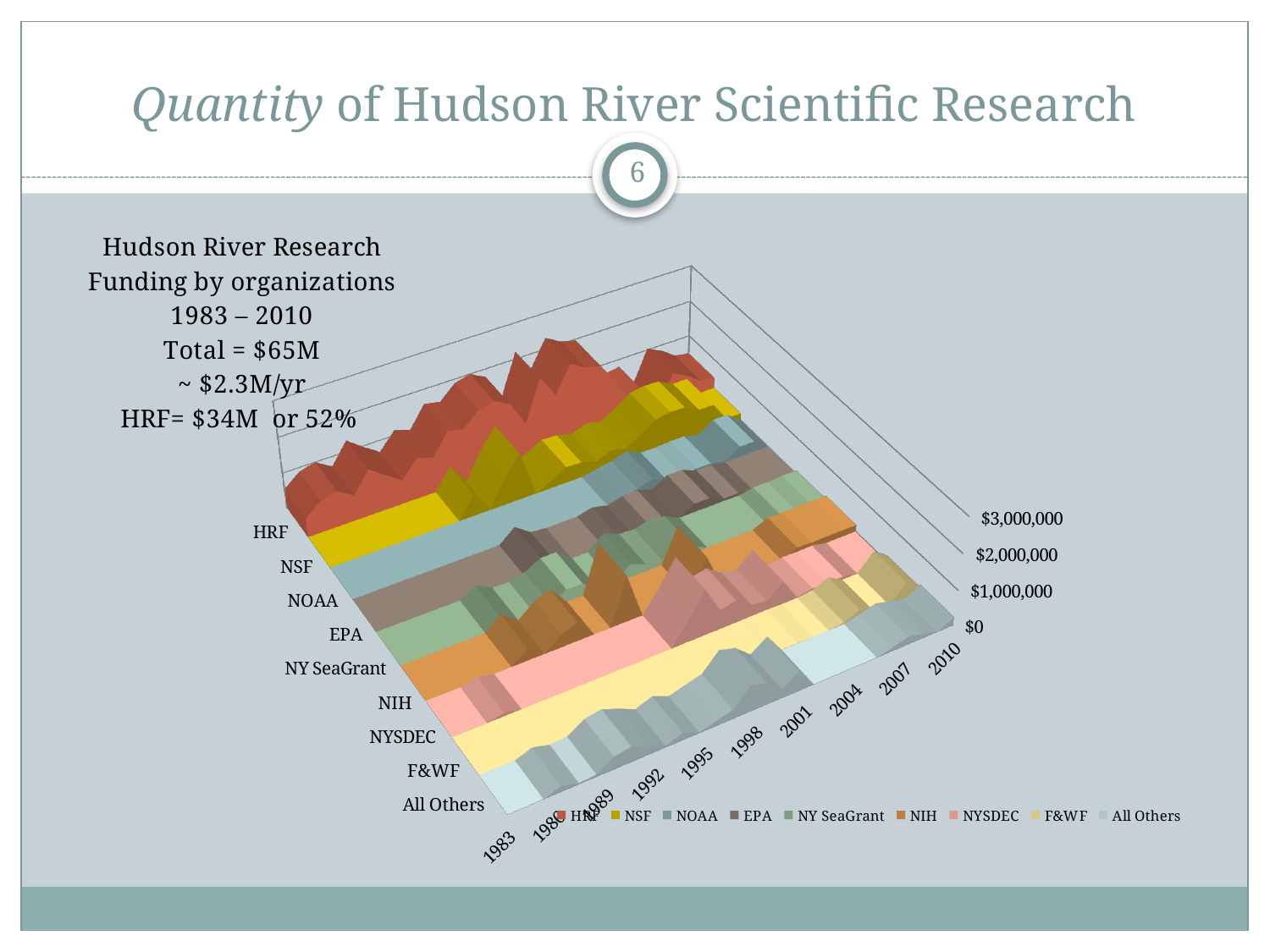
Which series is plotted between NOAA and NY SeaGrant? EPA What is the highest value labeled on the vertical axis? $3,000,000 What kind of chart is shown on the slide? 3D area chart Which organization's series shows the highest funding values in the chart? HRF Which series is listed last in the legend? All Others What is the last year labeled on the horizontal axis? 2010 What is the lowest value labeled on the vertical axis? $0 How many year labels are shown along the horizontal axis? 10 Which series is listed first in the legend? HRF What is the first year labeled on the horizontal axis? 1983 How many series does the legend list? 9